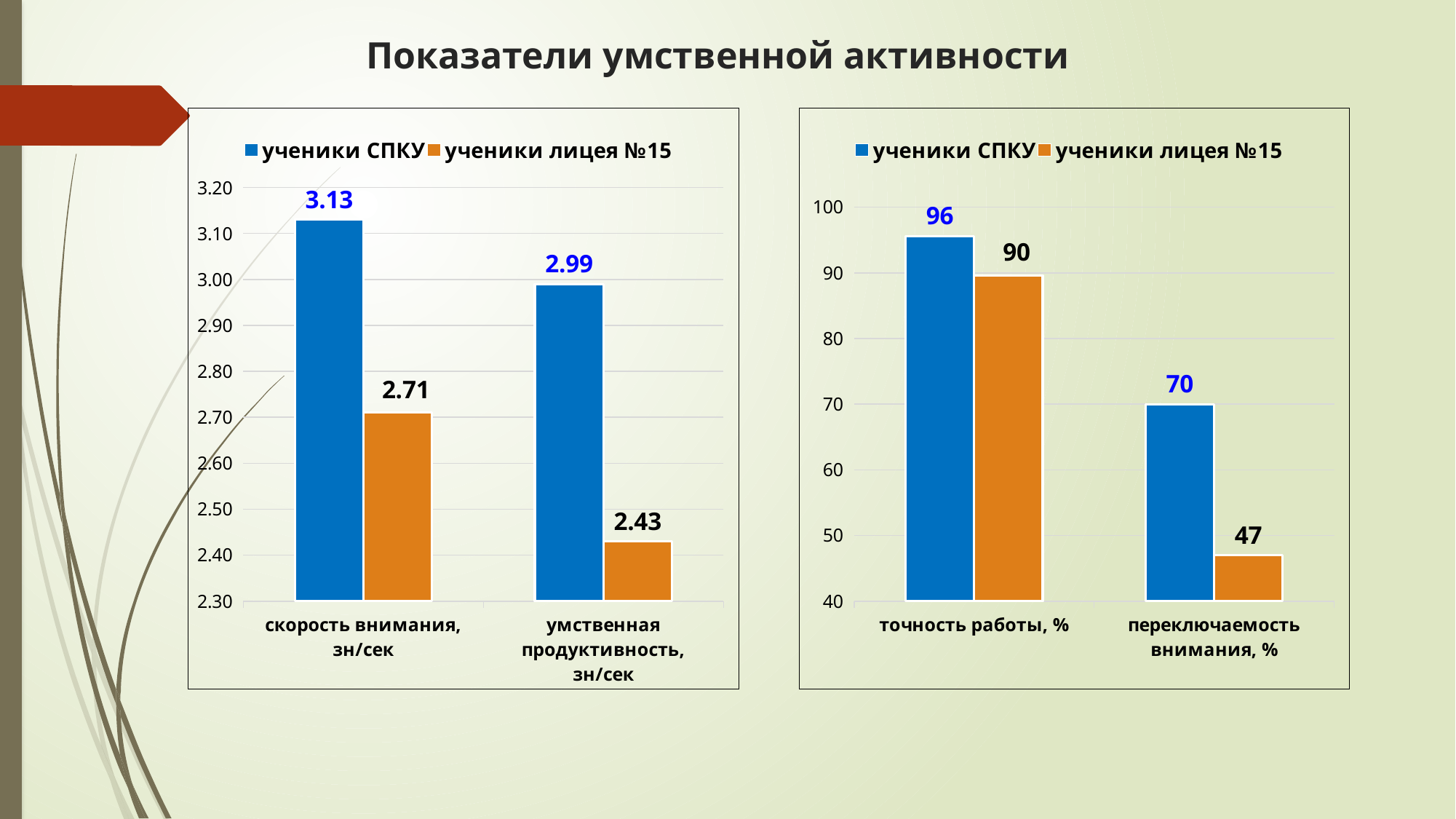
In the right chart, which bar is the highest? ученики СПКУ, точность работы, % What type of chart is the left chart? bar chart How many series does the legend of the left chart list? 2 In the left chart, what is the difference between ученики СПКУ and ученики лицея №15 for скорость внимания, зн/сек? 0.42 In the right chart, which series has the higher value for точность работы, %? ученики СПКУ In the left chart, what is the value for ученики лицея №15 for умственная продуктивность, зн/сек? 2.43 In the left chart, which bar is the lowest? ученики лицея №15, умственная продуктивность, зн/сек In the right chart, what is the value for ученики лицея №15 for точность работы, %? 90 How many categories are shown on the x axis of the right chart? 2 In the left chart, what is the value for ученики СПКУ for скорость внимания, зн/сек? 3.13 In the right chart, what is the difference between ученики СПКУ and ученики лицея №15 for переключаемость внимания, %? 23 In the right chart, what is the value for ученики СПКУ for переключаемость внимания, %? 70